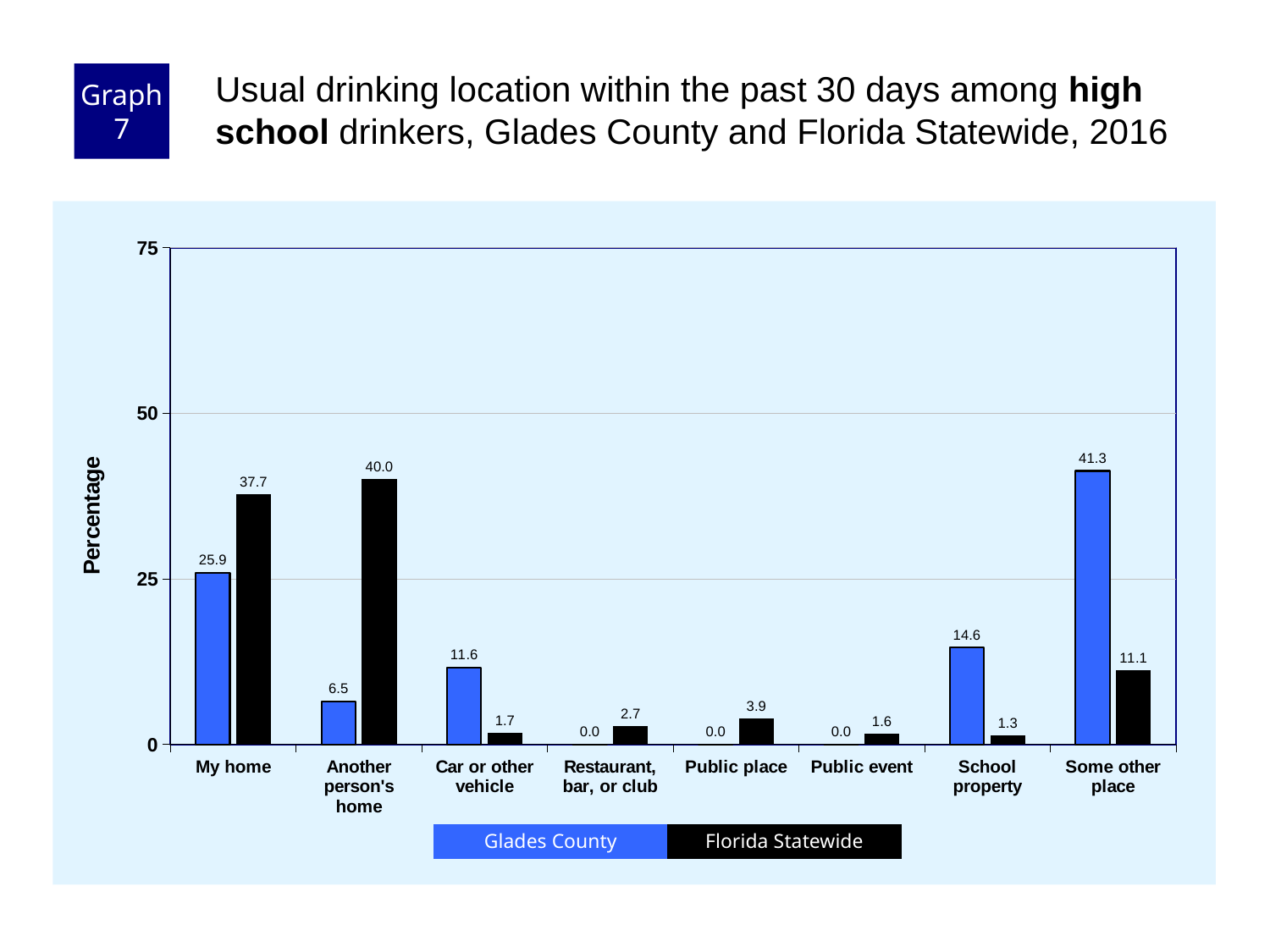
Which category has the highest Glades County value? Some other place What kind of chart is shown? Bar chart Which category has the lowest Florida Statewide value? School property What is the difference between the Florida Statewide and Glades County values for 'My home'? 11.8 What is the Glades County value for 'School property'? 14.6 What is the Glades County value for 'My home'? 25.9 Is the Florida Statewide value for 'My home' greater or less than 25? greater What is the Florida Statewide value for 'Another person's home'? 40.0 Which is larger for 'Some other place': Glades County or Florida Statewide? Glades County How many location categories are shown on the x axis? 8 Which category has the highest Florida Statewide value? Another person's home How many series does the legend list? 2